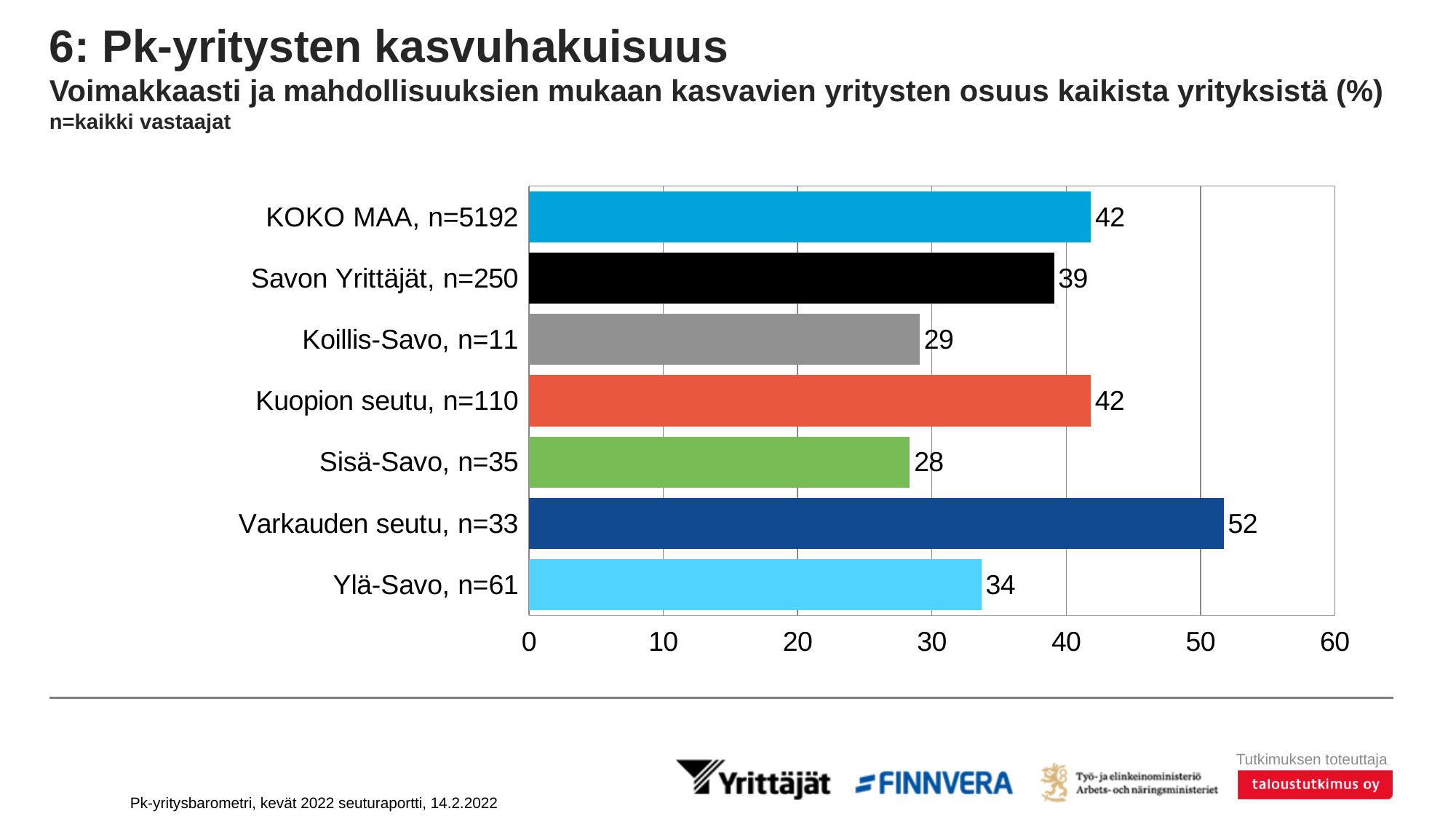
Which category has the lowest value? Sisä-Savo, n=35 What kind of chart is shown on the slide? bar chart What is the value for KOKO MAA, n=5192? 42 Which category has the highest value? Varkauden seutu, n=33 What is the difference between the values for Varkauden seutu, n=33 and Savon Yrittäjät, n=250? 13 What is the value for Varkauden seutu, n=33? 52 What is the value for Koillis-Savo, n=11? 29 Which is larger, the value for Ylä-Savo, n=61 or the value for Sisä-Savo, n=35? Ylä-Savo, n=61 How many categories are shown in the chart? 7 What is the maximum value shown on the x axis? 60 What is the value for Ylä-Savo, n=61? 34 Is the value for Kuopion seutu, n=110 greater or less than 40? greater